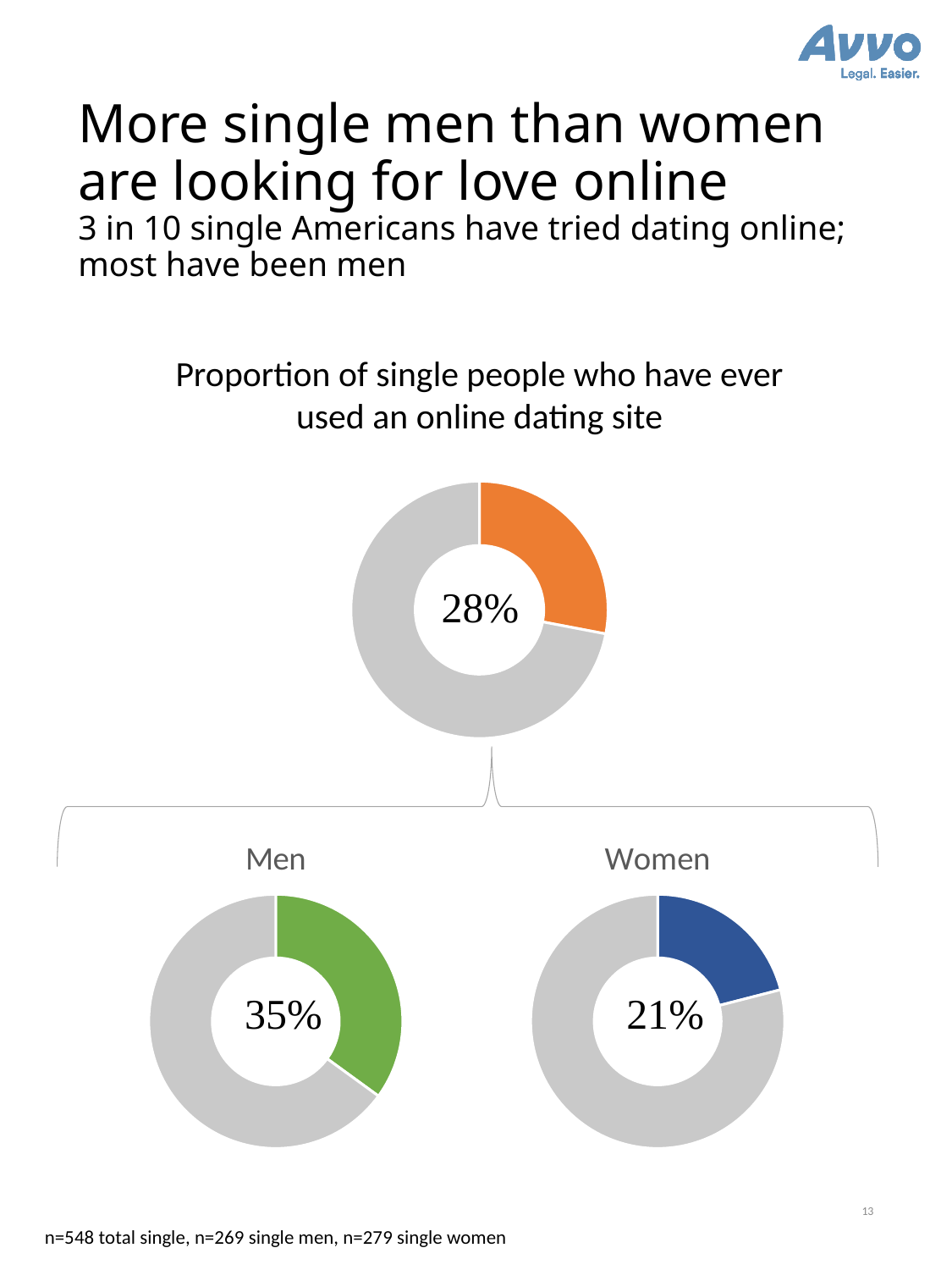
In the top chart titled 'Proportion of single people who have ever used an online dating site', what percentage is shown in the centre? 28% Comparing the 'Men' and 'Women' charts, which group has the higher proportion who have used an online dating site? Men In the 'Women' chart at the bottom right, what percentage of single women have ever used an online dating site? 21% How many charts are shown on the slide? 3 What is the difference between the percentage shown in the 'Men' chart and the percentage shown in the 'Women' chart? 14 percentage points What colour is the highlighted slice in the 'Men' chart? Green In the top chart, what share of the ring is taken up by the orange slice? 28% Of the three charts on the slide, which one shows the lowest percentage? Women What kind of chart is used on this slide to show the proportions? Pie chart (donut) What colour is the highlighted slice in the 'Women' chart? Blue In the 'Men' chart at the bottom left, what percentage of single men have ever used an online dating site? 35% Of the three charts on the slide, which one shows the highest percentage? Men